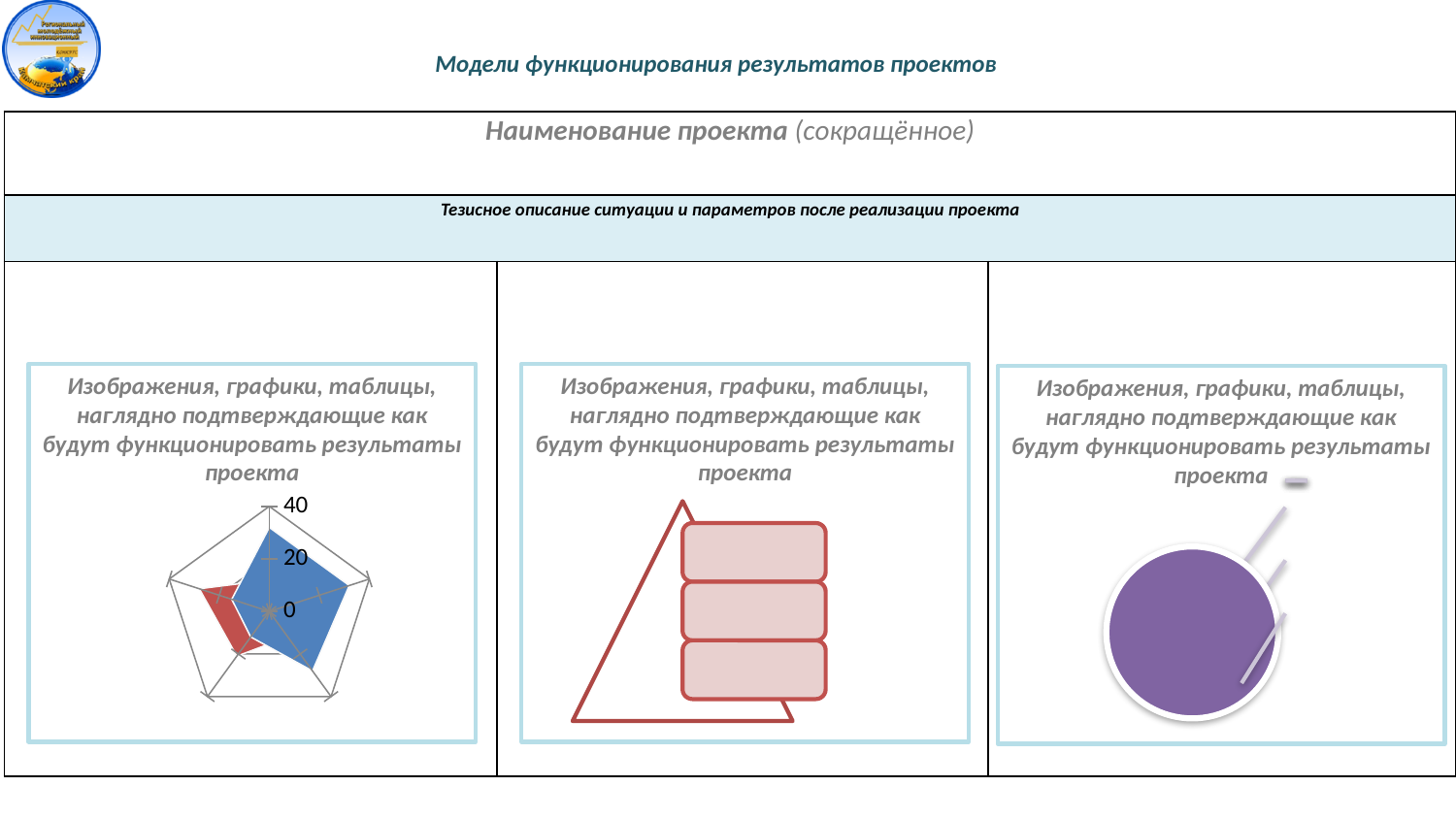
What kind of chart is shown in the left panel of the slide? radar chart How many axes (spokes) does the radar chart in the left panel have? 5 What is the highest tick value shown on the axis of the radar chart in the left panel? 40 How many differently coloured data series are plotted on the radar chart in the left panel? 2 On the radar chart in the left panel, which series covers the larger area, the blue one or the red one? blue